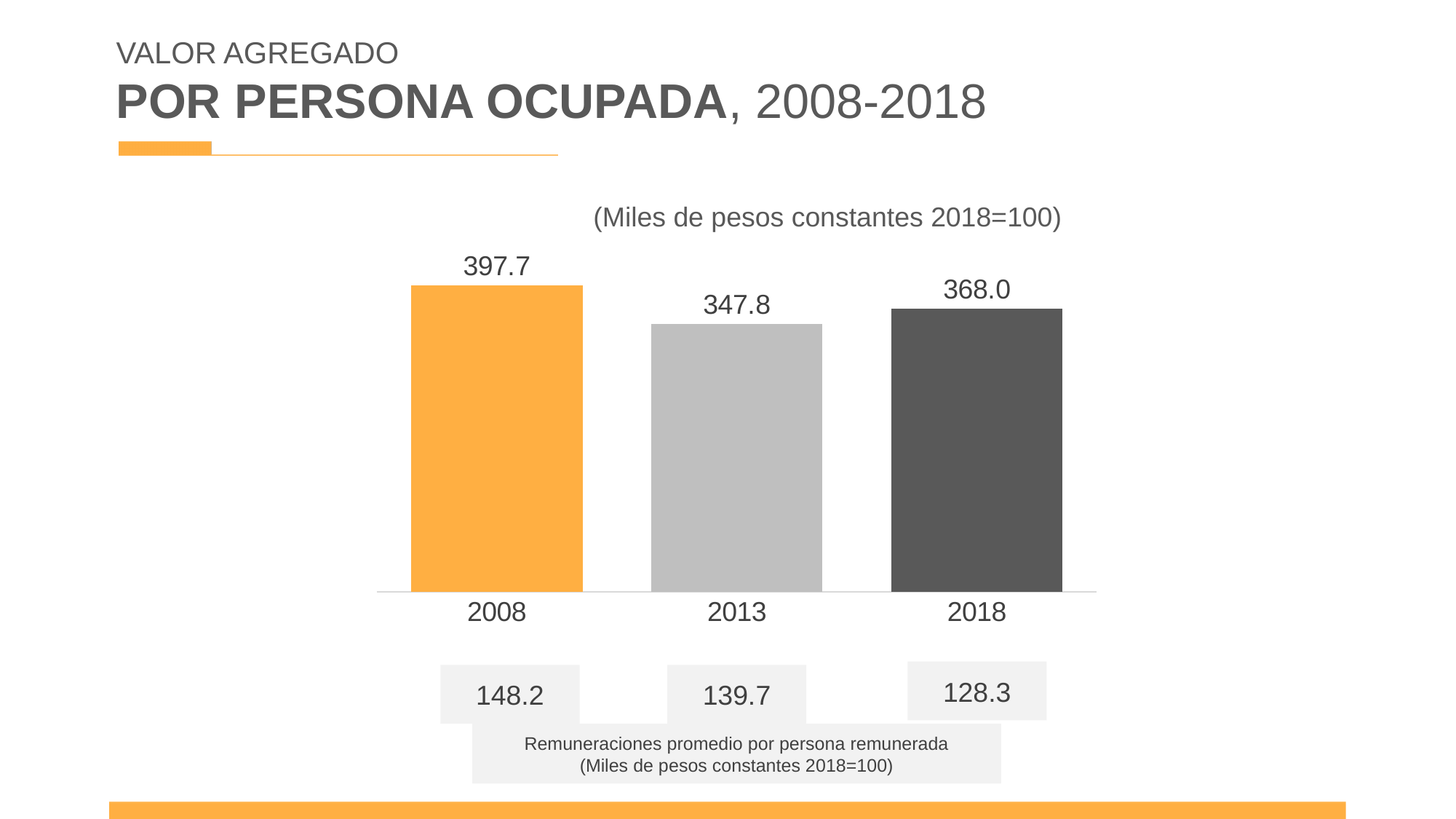
What unit is stated above the bar chart? Miles de pesos constantes 2018=100 What is the difference between the 2018 and 2013 values in the bar chart? 20.2 What is the difference between the 2008 and 2013 values in the bar chart? 49.9 What kind of chart is shown on the slide? bar chart What colour is the bar for 2008? orange Which year has the highest value in the bar chart? 2008 How many years are shown in the bar chart? 3 What is the value for 2018 in the bar chart? 368.0 Which year has the lowest value in the bar chart? 2013 Which is larger in the bar chart, the value for 2018 or the value for 2013? 2018 What is the value for 2013 in the bar chart? 347.8 What is the value for 2008 in the bar chart? 397.7